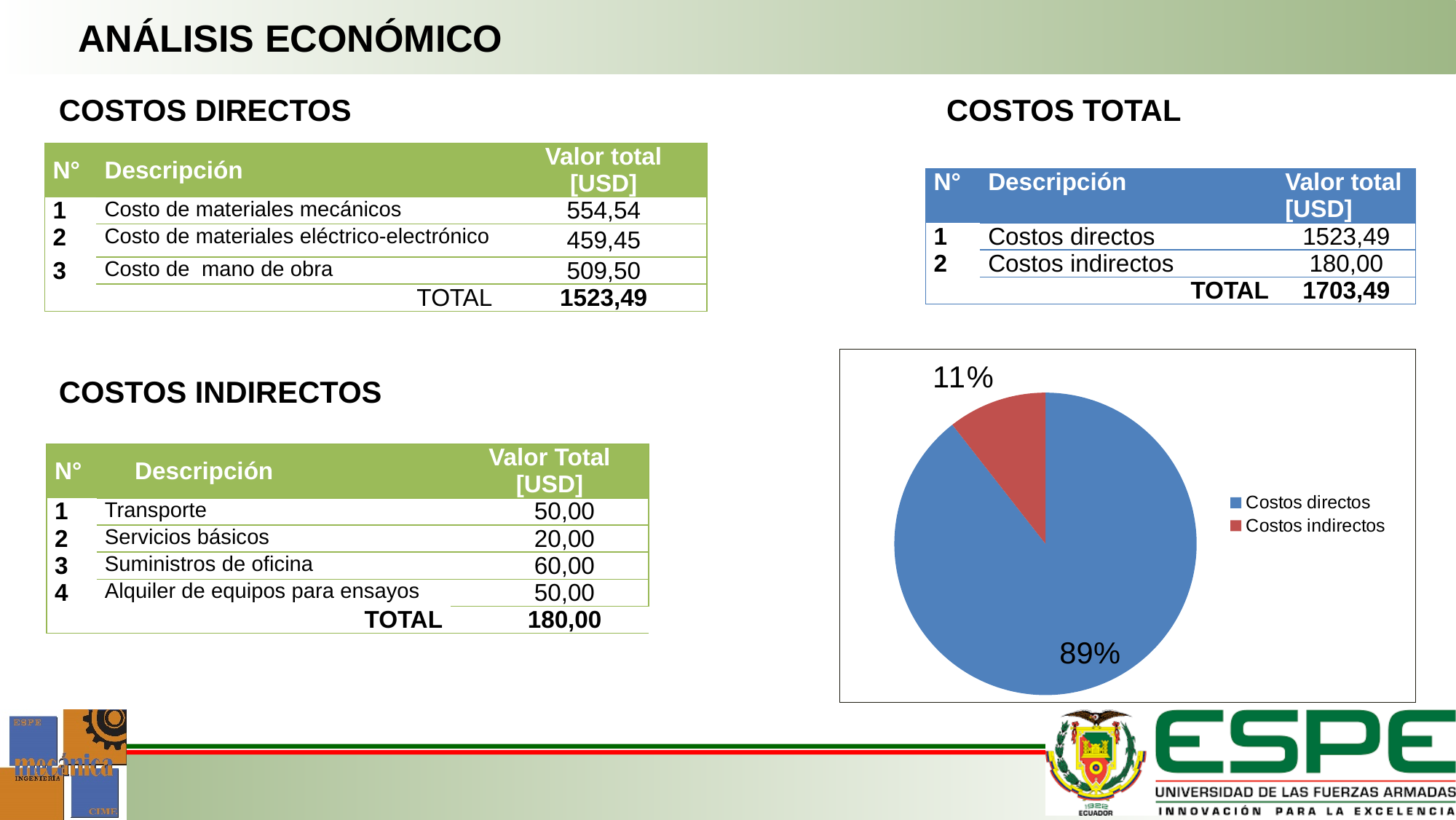
What share of the pie chart does Costos indirectos represent? 11% By how many percentage points does the Costos directos share exceed the Costos indirectos share in the pie chart? 78 What colour is the Costos indirectos slice in the pie chart? red Which slice of the pie chart is the largest? Costos directos What kind of chart is shown on the slide? pie chart Which is larger in the pie chart, Costos directos or Costos indirectos? Costos directos What share of the pie chart does Costos directos represent? 89% What colour is the Costos directos slice in the pie chart? blue How many slices does the pie chart have? 2 How many entries does the pie chart's legend list? 2 Which slice of the pie chart is the smallest? Costos indirectos